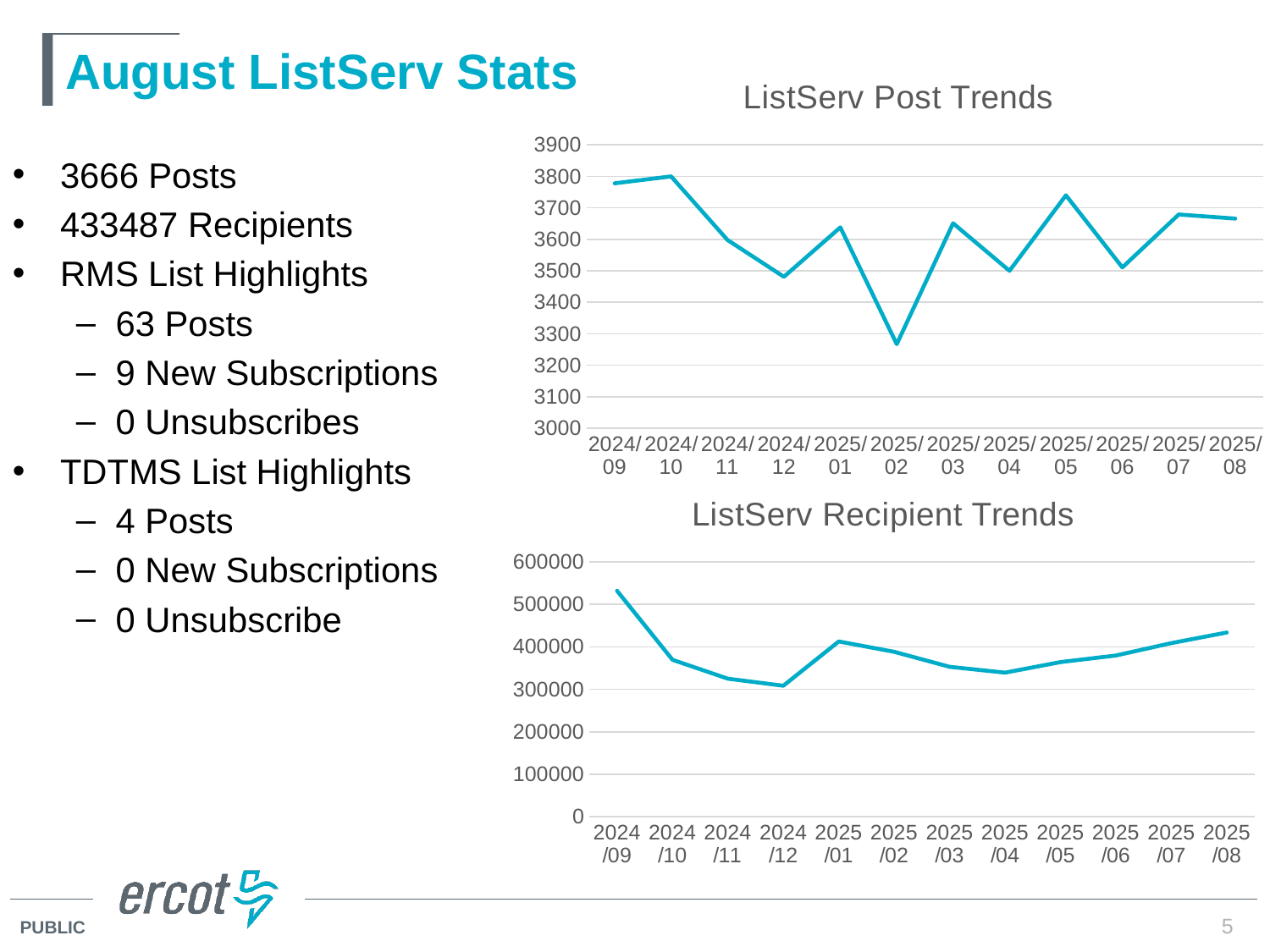
On the ListServ Post Trends chart, which month has the lowest value? 2025/02 On the ListServ Post Trends chart, which is larger, the value for 2024/09 or the value for 2025/02? 2024/09 On the ListServ Recipient Trends chart, is the value for 2025/04 greater or less than 400000? less On the ListServ Recipient Trends chart, is the value for 2024/09 greater or less than 500000? greater On the ListServ Post Trends chart, is the value for 2025/02 greater or less than 3300? less What is the title of the top chart on the slide? ListServ Post Trends How many data points are plotted on the ListServ Recipient Trends chart? 12 On the ListServ Recipient Trends chart, which is larger, the value for 2024/09 or the value for 2025/08? 2024/09 On the ListServ Recipient Trends chart, do the values rise or fall from 2025/04 to 2025/08? rise What kind of chart is the ListServ Post Trends chart? line chart On the ListServ Recipient Trends chart, which month has the highest value? 2024/09